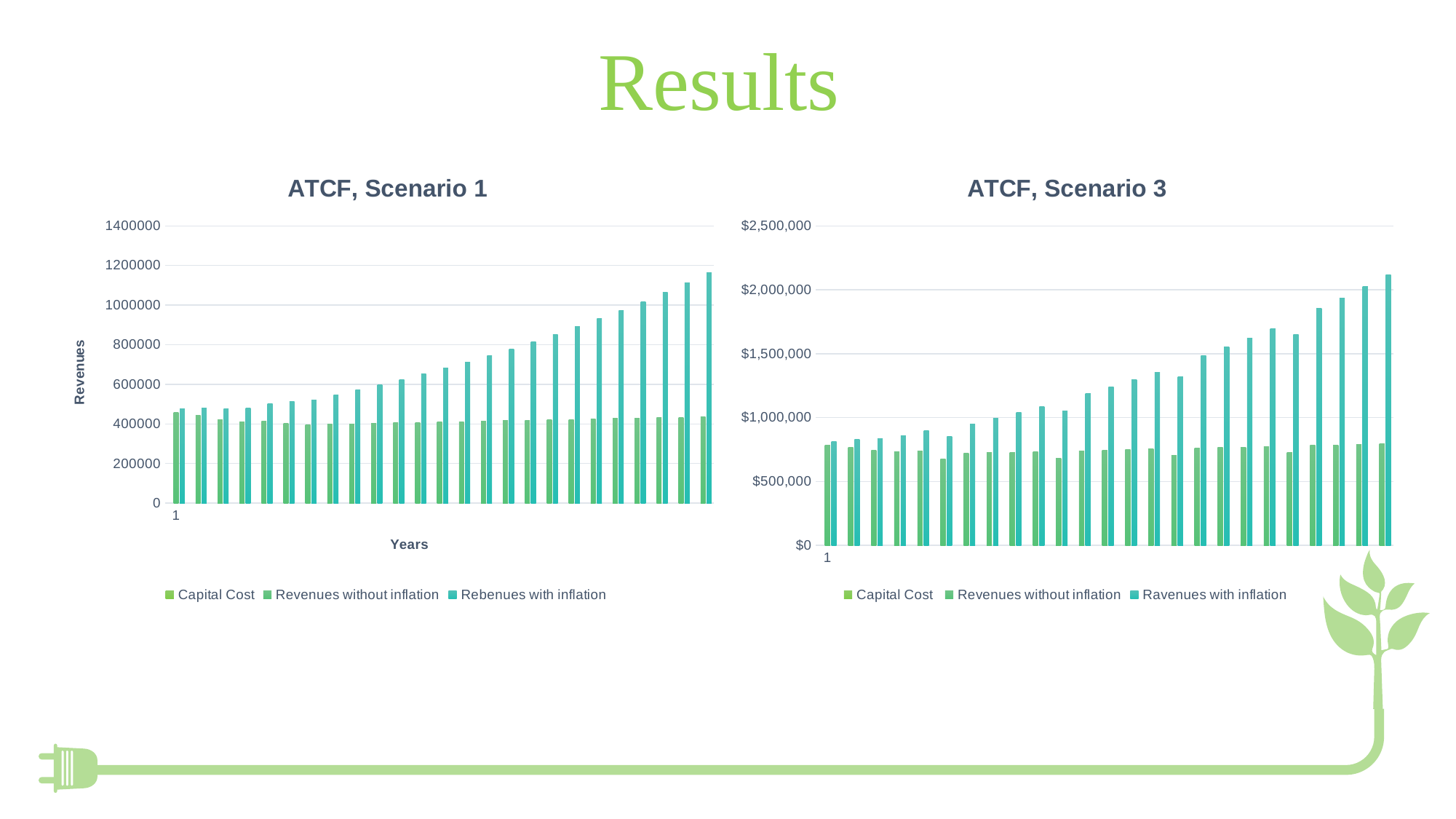
In the "ATCF, Scenario 1" chart, which series has the tallest bar? Rebenues with inflation In the "ATCF, Scenario 1" chart, do the values for Rebenues with inflation rise or fall along the x axis? Rise What kind of chart is the "ATCF, Scenario 1" chart? Bar chart In the "ATCF, Scenario 1" chart, what is the third legend entry? Rebenues with inflation In the "ATCF, Scenario 3" chart, is the value of the first Ravenues with inflation bar greater or less than $1,000,000? less In the "ATCF, Scenario 3" chart, is the value of the last Ravenues with inflation bar greater or less than $2,000,000? greater In the "ATCF, Scenario 1" chart, is the value of the last Rebenues with inflation bar greater or less than 1000000? greater In the "ATCF, Scenario 3" chart, do the values for Ravenues with inflation rise or fall along the x axis? Rise In the "ATCF, Scenario 1" chart, what is the title of the vertical axis? Revenues How many series does the legend of the "ATCF, Scenario 3" chart list? 3